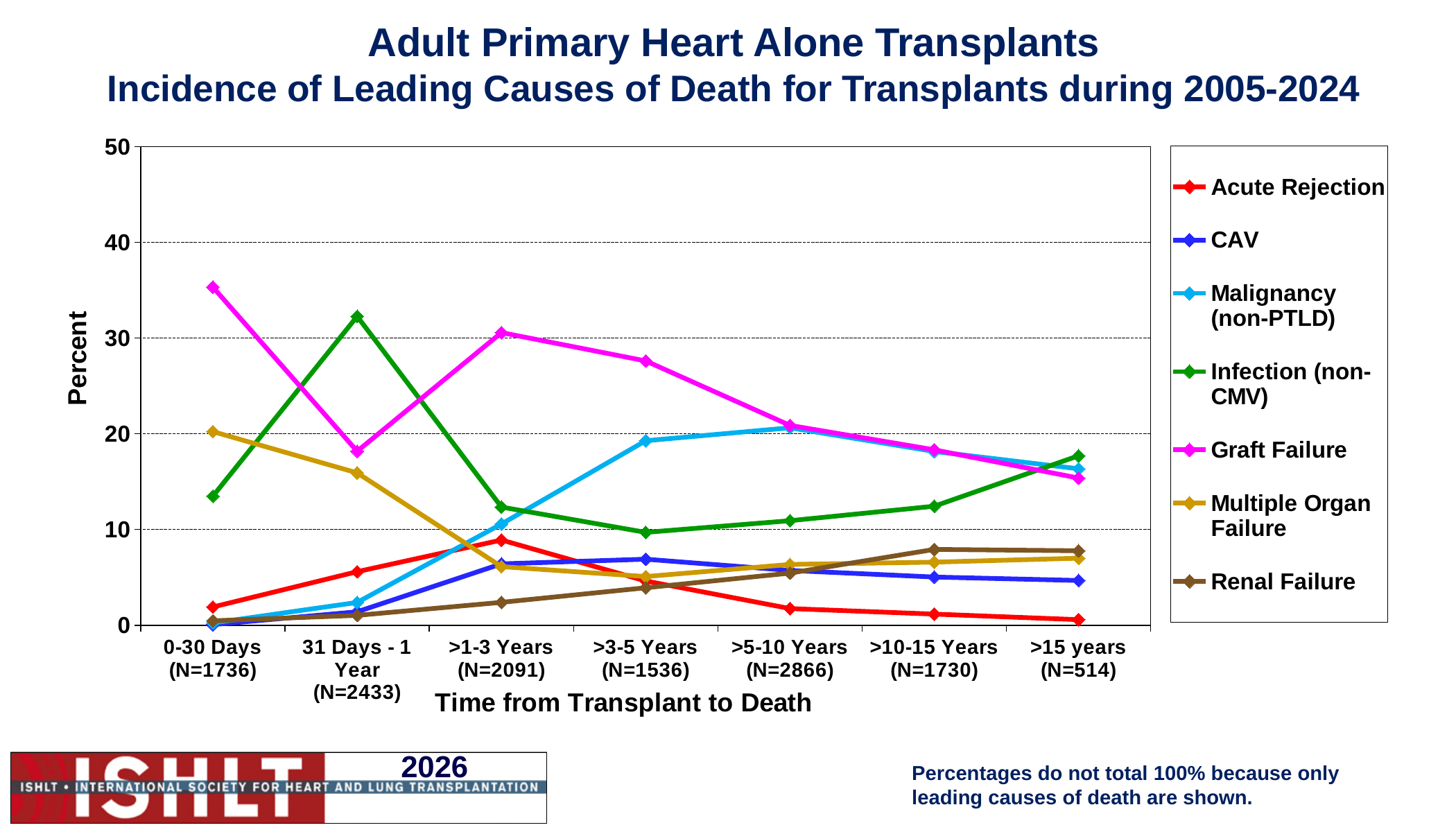
Is the value for Graft Failure at 0-30 Days greater or less than 30? greater What is the label of the y axis? Percent How many time-period categories are shown on the x axis? 7 Which cause of death has the highest percentage at >1-3 Years? Graft Failure How many series does the legend list? 7 Which is larger at >15 years, the value for CAV or the value for Acute Rejection? CAV Is the value for Infection (non-CMV) at 31 Days - 1 Year greater or less than 30? greater Is the value for Acute Rejection at >15 years greater or less than 10? less Does the Acute Rejection line rise or fall from >1-3 Years to >15 years? fall Which cause of death has the highest percentage at 0-30 Days? Graft Failure Which cause of death has the highest percentage at 31 Days - 1 Year? Infection (non-CMV) What kind of chart is shown on the slide? line chart